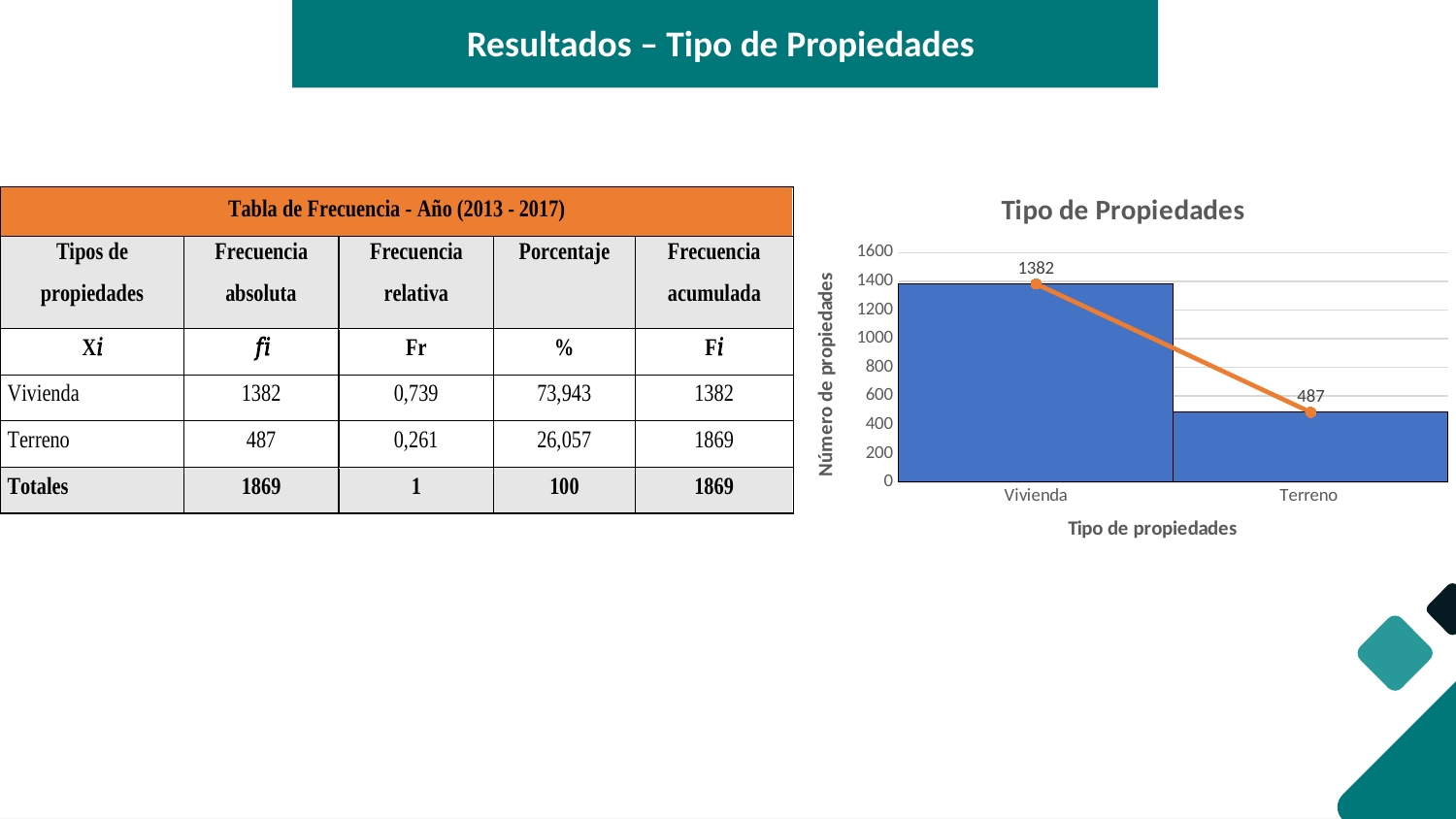
What is the value for Vivienda in the chart? 1382 What kind of chart is shown on the slide? Bar chart with a line overlay What is the value for Terreno in the chart? 487 Do the values rise or fall from Vivienda to Terreno along the x axis? fall How many categories are shown on the x axis of the chart? 2 Which category has the lowest value in the chart? Terreno Which is larger, the value for Vivienda or the value for Terreno? Vivienda Is the value for Terreno greater or less than 600? less Which category has the highest value in the chart? Vivienda Is the value for Vivienda greater or less than 1200? greater What is the title of the chart? Tipo de Propiedades What is the difference between the values for Vivienda and Terreno? 895